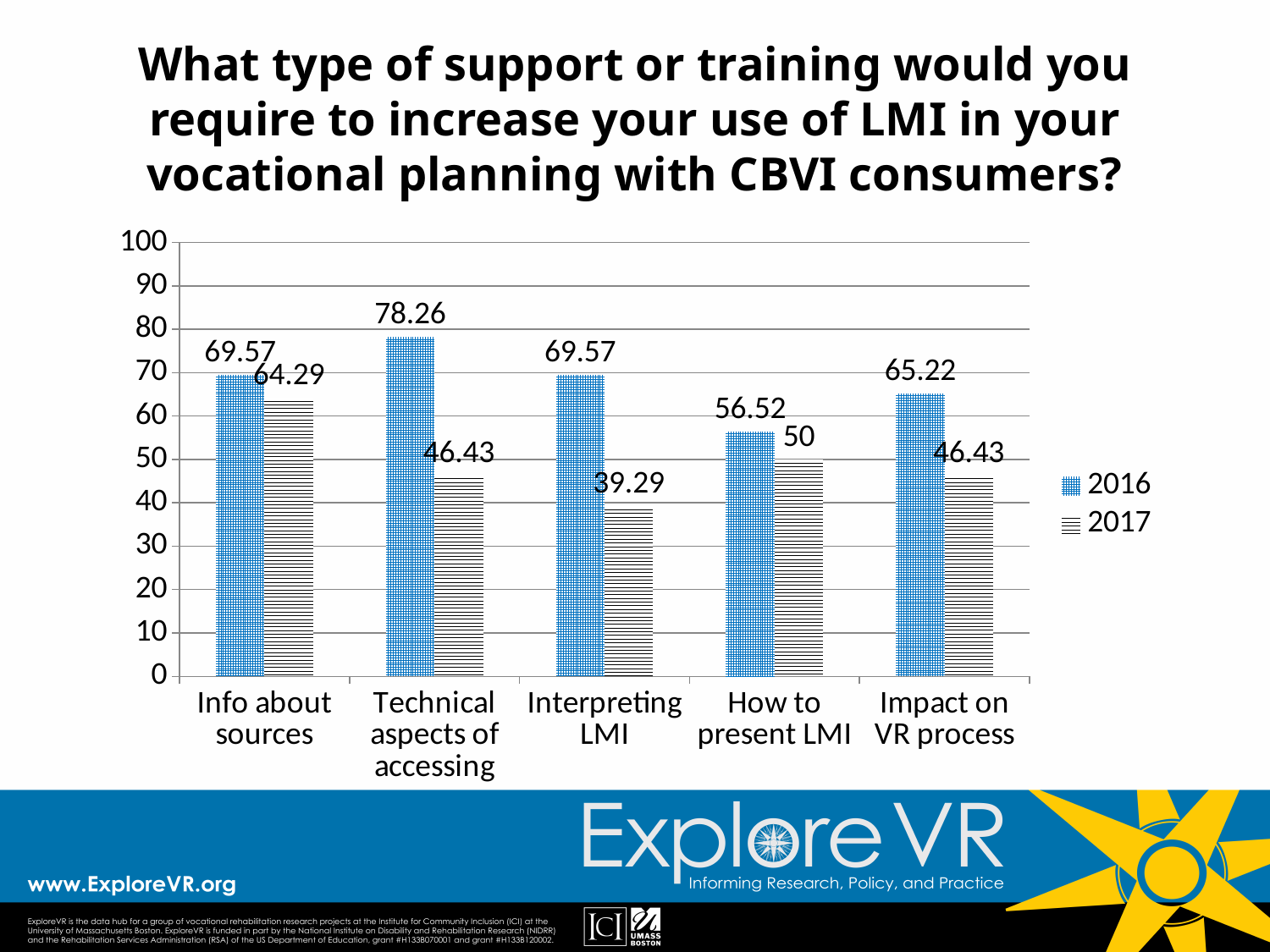
Which is larger for How to present LMI: the 2016 value or the 2017 value? 2016 What kind of chart is shown on the slide? Bar chart How many series does the legend list? 2 What is the difference between the 2016 and 2017 values for Technical aspects of accessing? 31.83 What is the 2016 value for Technical aspects of accessing? 78.26 What are the two series named in the legend? 2016 and 2017 Which category has the highest 2016 value? Technical aspects of accessing Which category has the lowest 2017 value? Interpreting LMI How many categories are shown on the x axis? 5 What is the 2016 value for Impact on VR process? 65.22 What is the 2017 value for How to present LMI? 50 What is the 2017 value for Interpreting LMI? 39.29